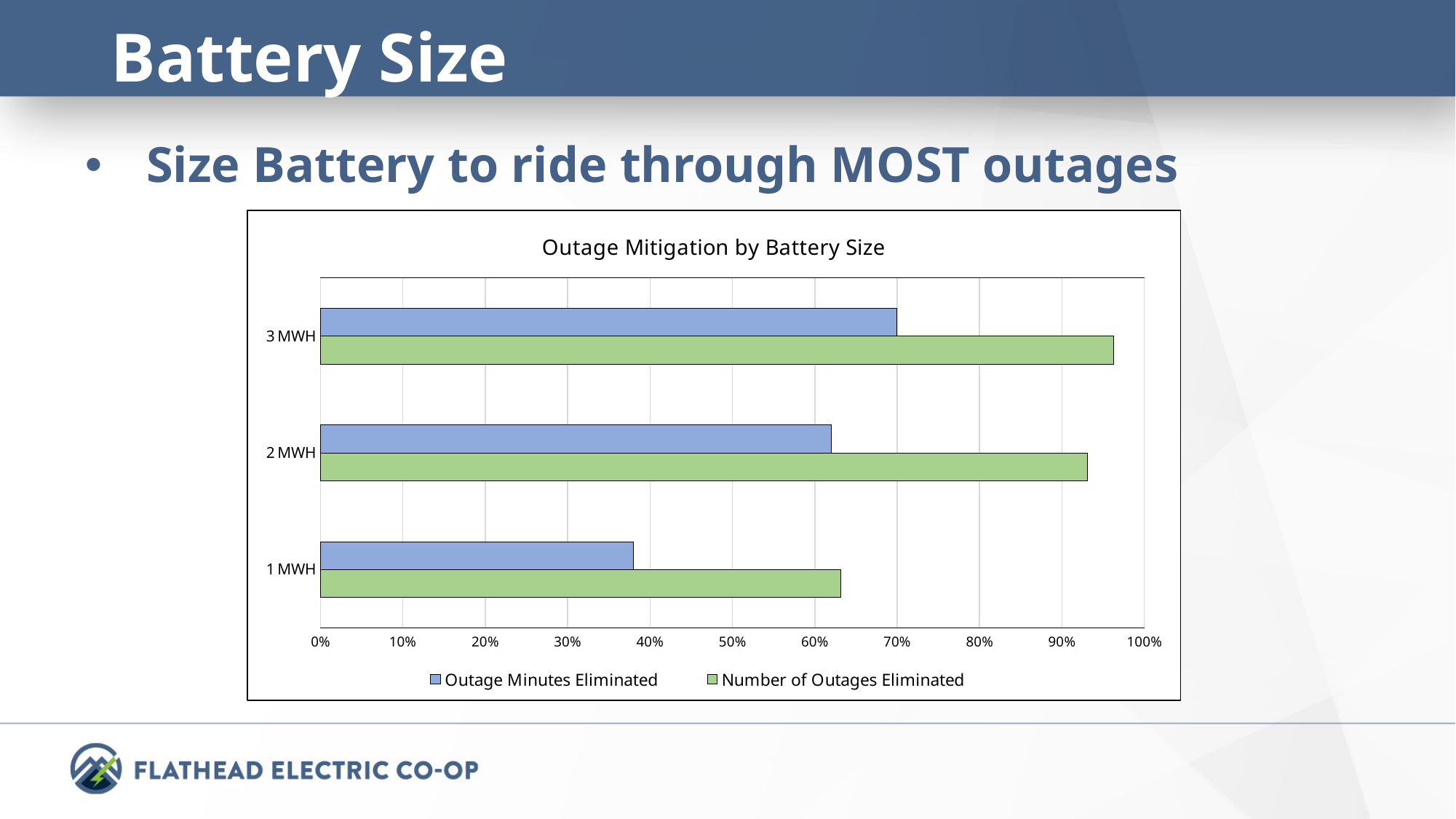
What is the title of the chart? Outage Mitigation by Battery Size Is the Outage Minutes Eliminated for 1 MWH greater or less than 40%? less Is the Number of Outages Eliminated for 3 MWH greater or less than 90%? greater How many series does the legend list? 2 Which battery size has the lowest Outage Minutes Eliminated? 1 MWH How many battery size categories are shown on the chart? 3 Do the Outage Minutes Eliminated values rise or fall as battery size increases from 1 MWH to 3 MWH? rise Is the Outage Minutes Eliminated for 2 MWH greater or less than 60%? greater Which battery size has the highest Number of Outages Eliminated? 3 MWH What type of chart is shown on the slide? bar chart For 1 MWH, which is larger: Outage Minutes Eliminated or Number of Outages Eliminated? Number of Outages Eliminated